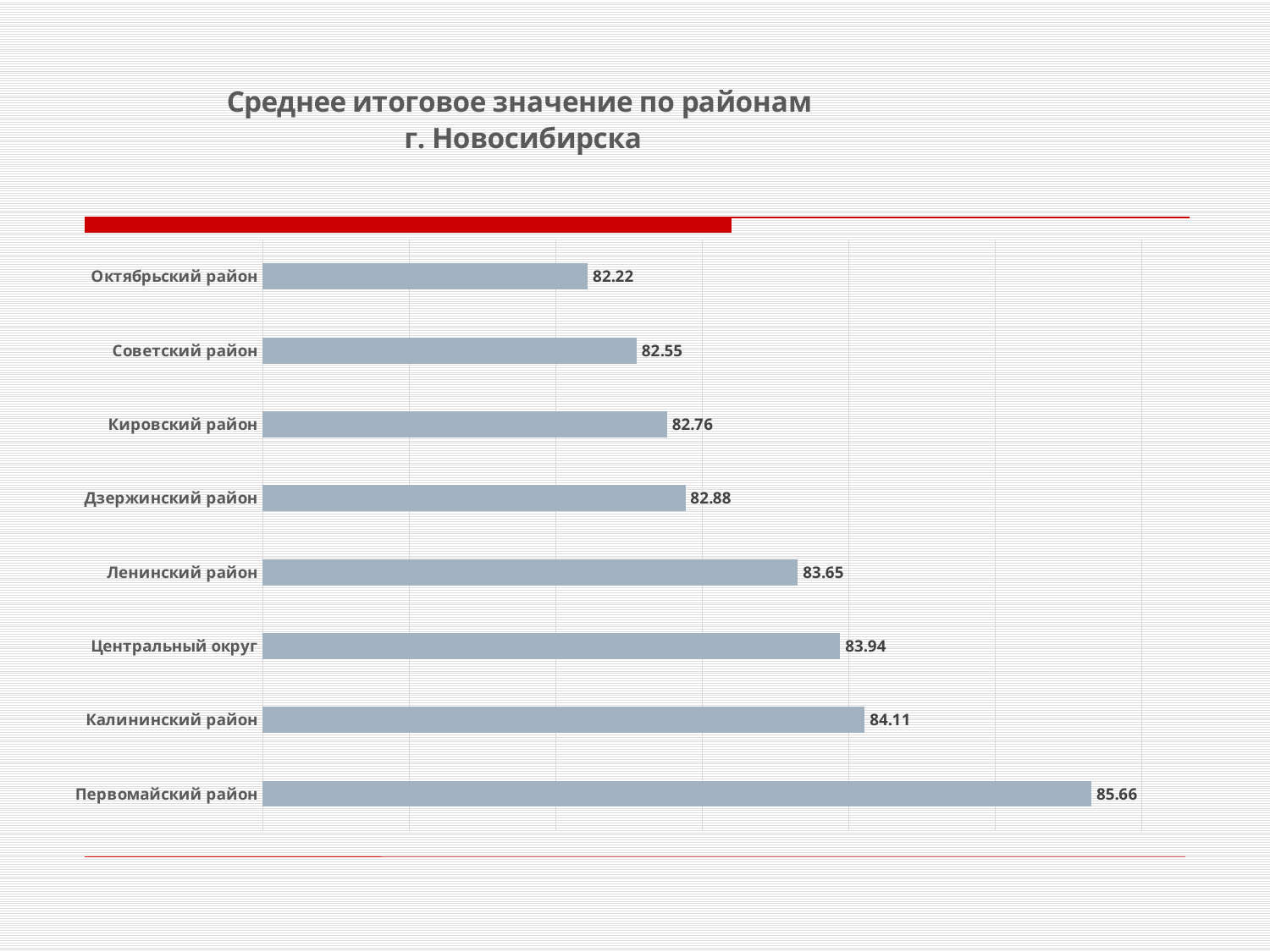
Which district has the highest value? Первомайский район What is the value for Ленинский район? 83.65 What is the value for Первомайский район? 85.66 What is the value for Центральный округ? 83.94 Which district has the lowest value? Октябрьский район What is the difference between the values for Ленинский район and Дзержинский район? 0.77 Which has a larger value, Калининский район or Кировский район? Калининский район What kind of chart is shown on the slide? Bar chart What is the difference between the values for Первомайский район and Октябрьский район? 3.44 How many districts are shown in the chart? 8 What is the value for Советский район? 82.55 What is the title of the chart? Среднее итоговое значение по районам г. Новосибирска